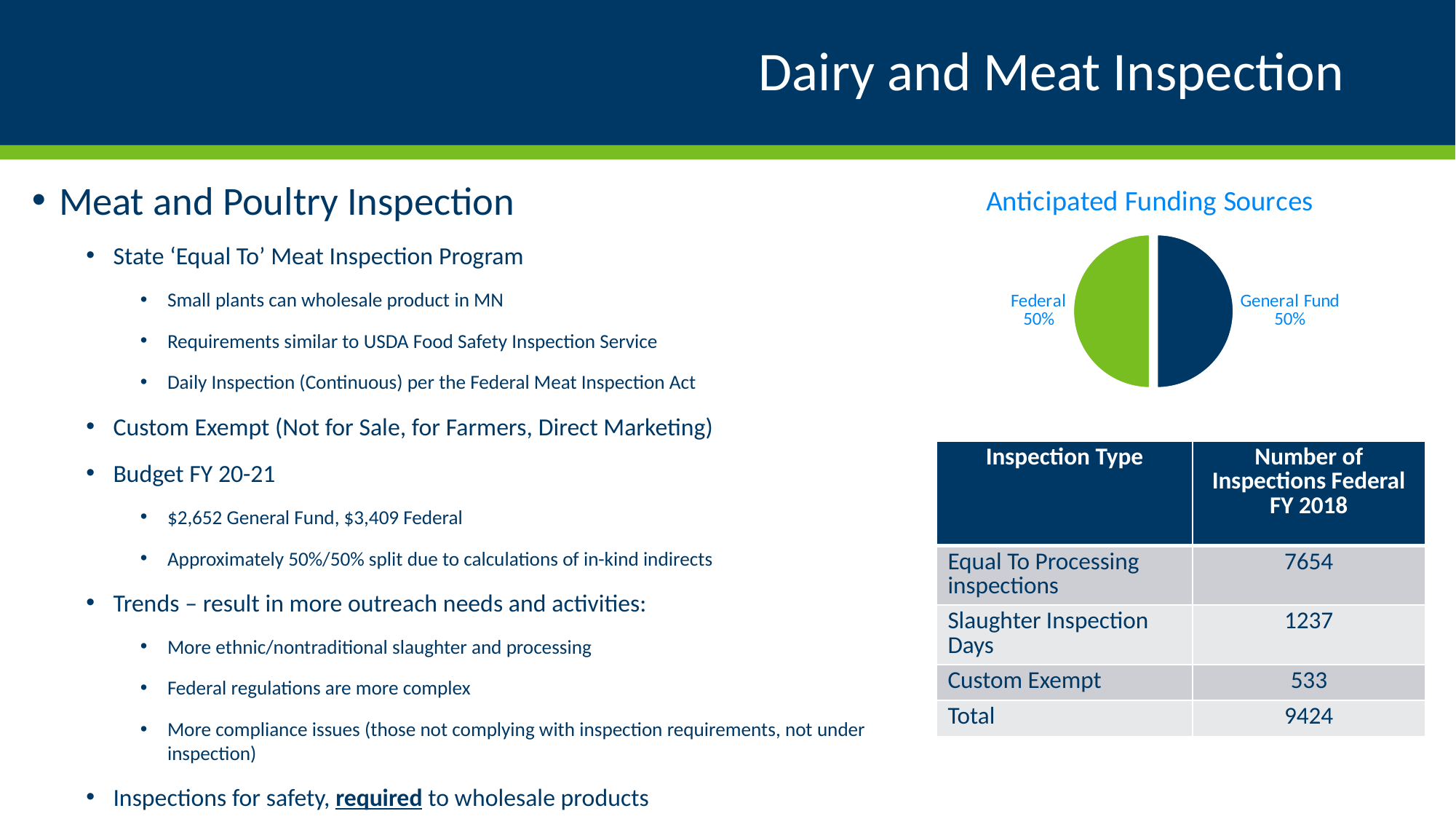
In the Anticipated Funding Sources pie chart, what is the difference between the Federal share and the General Fund share? 0% How many slices does the Anticipated Funding Sources pie chart have? 2 In the Anticipated Funding Sources pie chart, which colour is the Federal slice? green In the Anticipated Funding Sources pie chart, what share is labelled for Federal? 50% What is the title of the pie chart on the slide? Anticipated Funding Sources What kind of chart is shown under the title "Anticipated Funding Sources"? pie chart In the Anticipated Funding Sources pie chart, what are the two funding sources shown? Federal and General Fund In the Anticipated Funding Sources pie chart, what share is labelled for General Fund? 50%